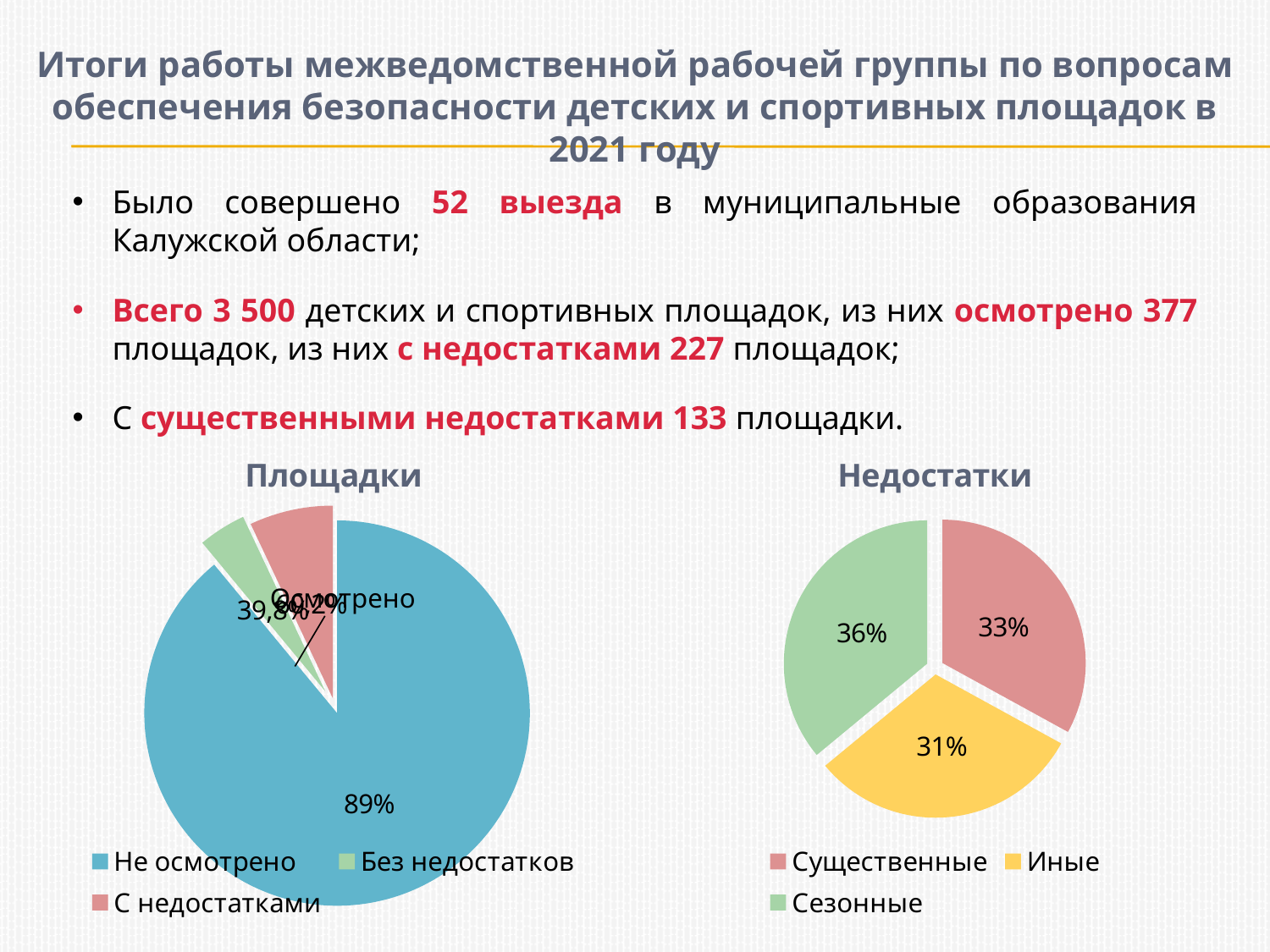
In the "Площадки" pie chart, what share is shown for Не осмотрено? 89% In the "Недостатки" pie chart, which is larger: Существенные or Иные? Существенные How many slices does the "Недостатки" pie chart have? 3 In the "Недостатки" pie chart, what share is shown for Сезонные? 36% In the "Недостатки" pie chart, by how many percentage points does Сезонные exceed Иные? 5 percentage points In the "Недостатки" pie chart, which category has the largest slice? Сезонные In the "Недостатки" pie chart, what share is shown for Иные? 31% In the "Недостатки" pie chart, what share is shown for Существенные? 33% In the "Недостатки" pie chart, which category has the smallest slice? Иные In the "Площадки" pie chart, which category has the largest slice? Не осмотрено How many entries does the legend of the "Площадки" chart list? 3 What type of chart is the "Площадки" chart? Pie chart